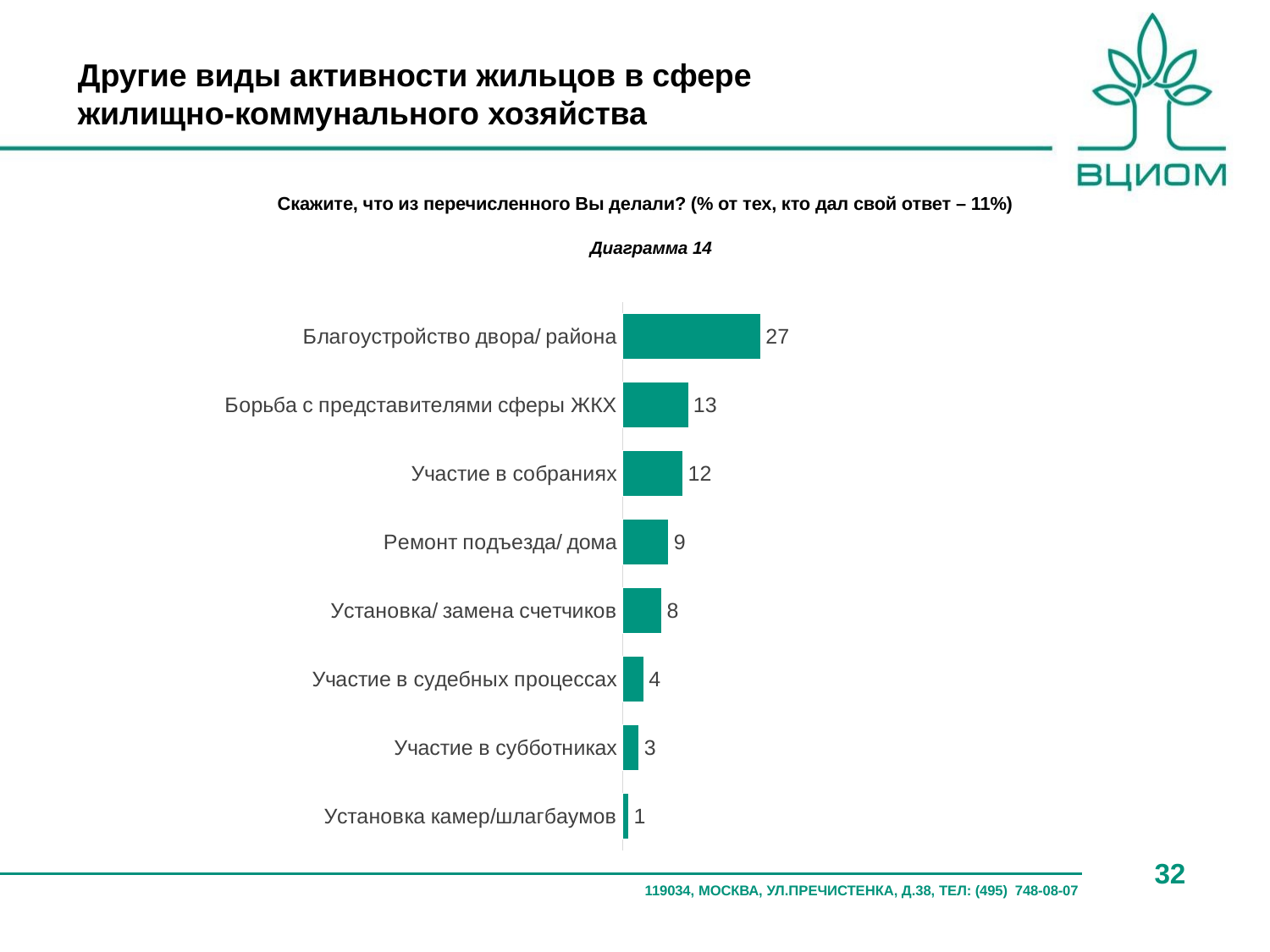
What is the value for Установка/ замена счетчиков? 8 What kind of chart is shown on the slide? Bar chart What is the value for Участие в собраниях? 12 What is the value for Благоустройство двора/ района? 27 What is the diagram number given above the chart? Диаграмма 14 Which is larger: the value for Участие в судебных процессах or the value for Установка/ замена счетчиков? Установка/ замена счетчиков How many categories are shown in the chart? 8 Which category has the highest value? Благоустройство двора/ района Which category has the lowest value? Установка камер/шлагбаумов What colour are the bars in the chart? Green What is the difference between the values for Ремонт подъезда/ дома and Участие в субботниках? 6 What is the difference between the values for Благоустройство двора/ района and Борьба с представителями сферы ЖКХ? 14